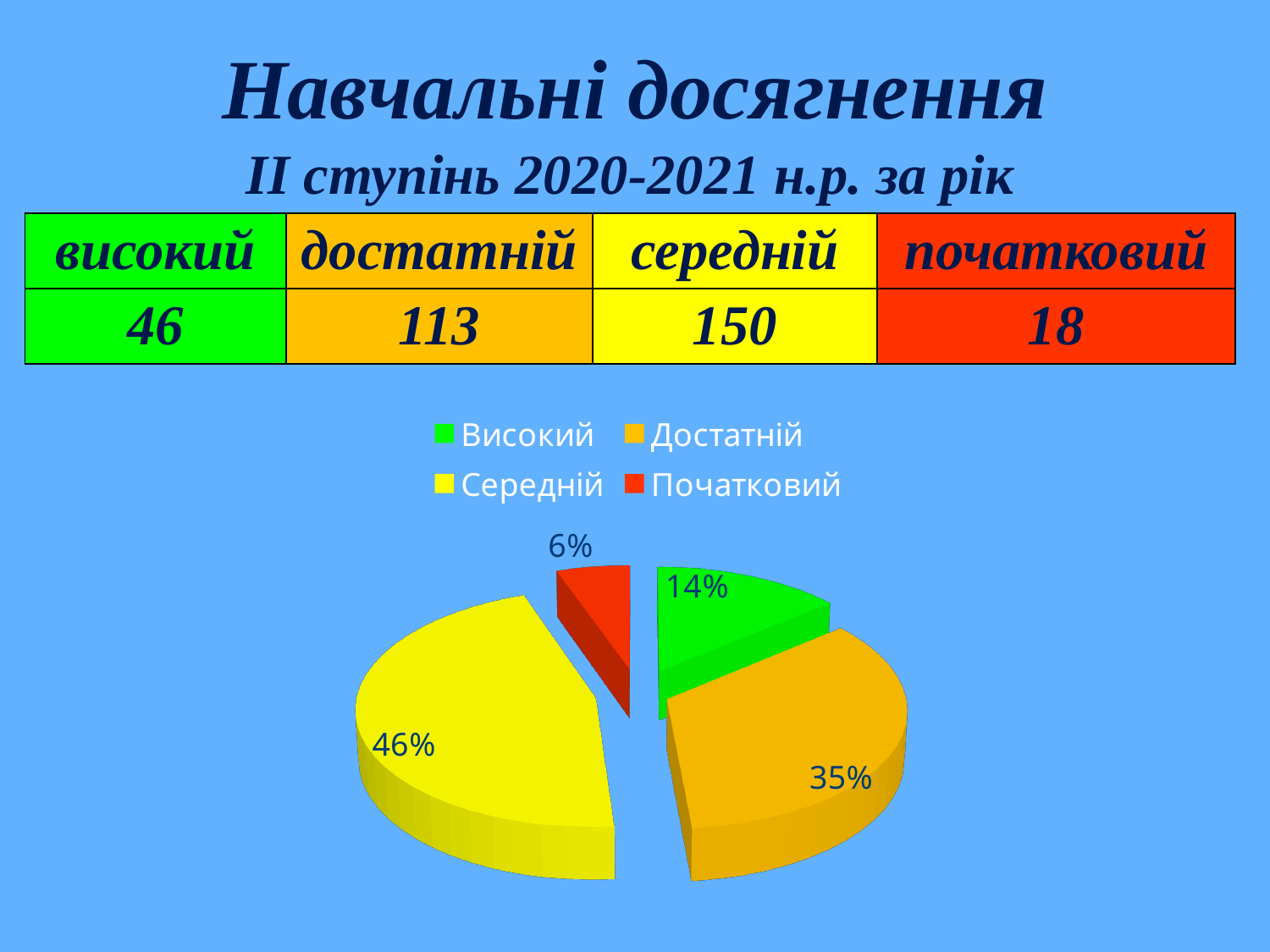
What colour is the Початковий slice in the pie chart? Red How many entries does the chart legend list? 4 Which category has the largest slice of the pie? Середній Which category has the smallest slice of the pie? Початковий What percentage is shown for the Початковий slice? 6% Which slice is larger, Високий or Достатній? Достатній What share of the pie does the Середній slice represent? 46% What is the difference in percentage points between the Середній and Достатній slices? 11 What type of chart is shown on the slide? Pie chart What percentage is shown for the Високий slice? 14% How many slices does the pie chart have? 4 What percentage is shown for the Достатній slice? 35%